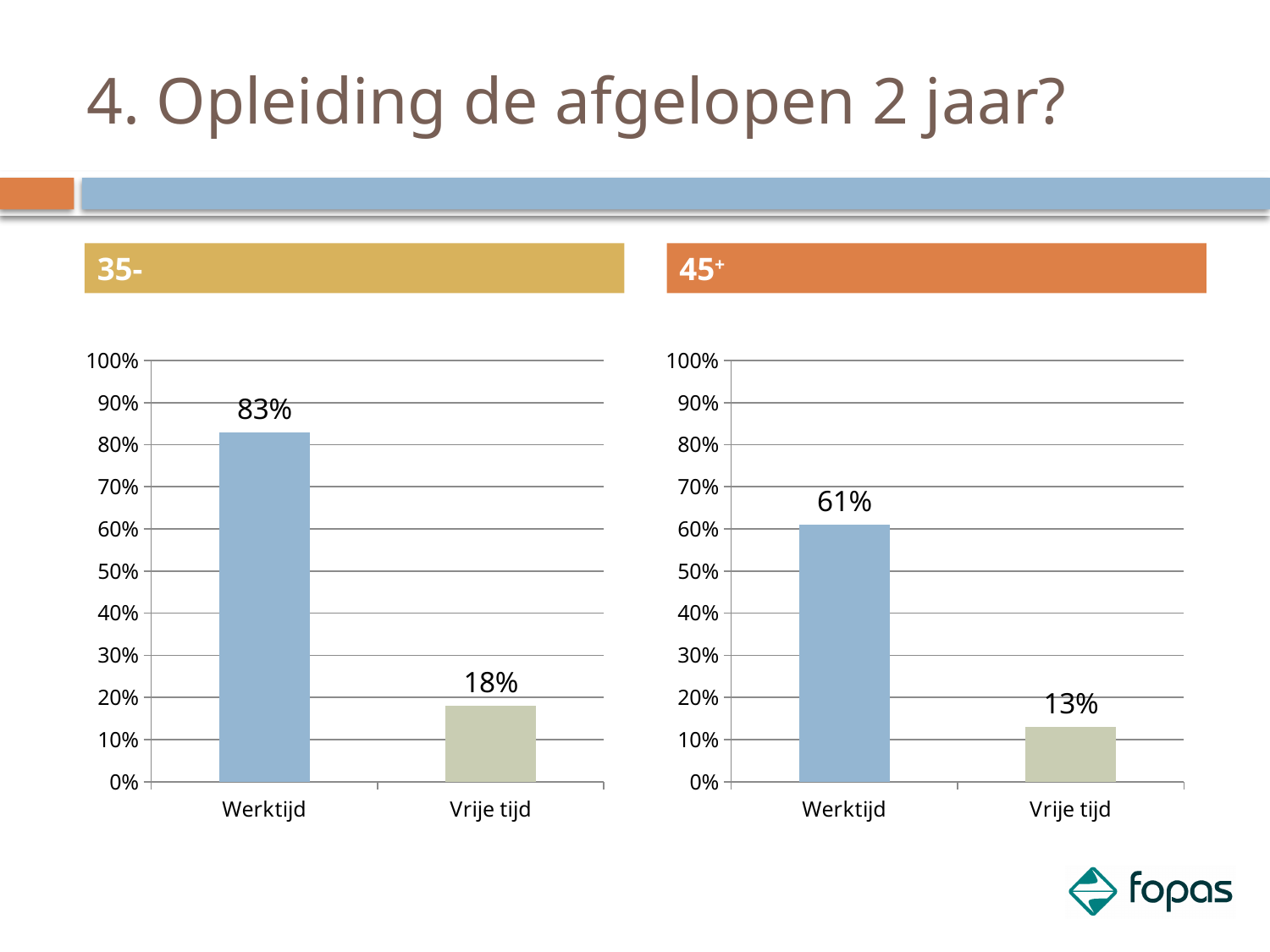
What type of chart is the 45+ chart? Bar chart How many categories are shown in the 35- chart? 2 Which is larger: Werktijd in the 35- chart or Werktijd in the 45+ chart? Werktijd in the 35- chart In the 35- chart, what is the value for Werktijd? 83% In the 45+ chart, what is the difference between Werktijd and Vrije tijd? 48% In the 45+ chart, is the value for Werktijd greater or less than 50%? greater In the 45+ chart, which category has the lowest value? Vrije tijd In the 45+ chart, what is the value for Werktijd? 61% In the 35- chart, what is the value for Vrije tijd? 18% In the 35- chart, which category has the highest value? Werktijd In the 35- chart, what is the difference between Werktijd and Vrije tijd? 65% In the 45+ chart, what is the value for Vrije tijd? 13%